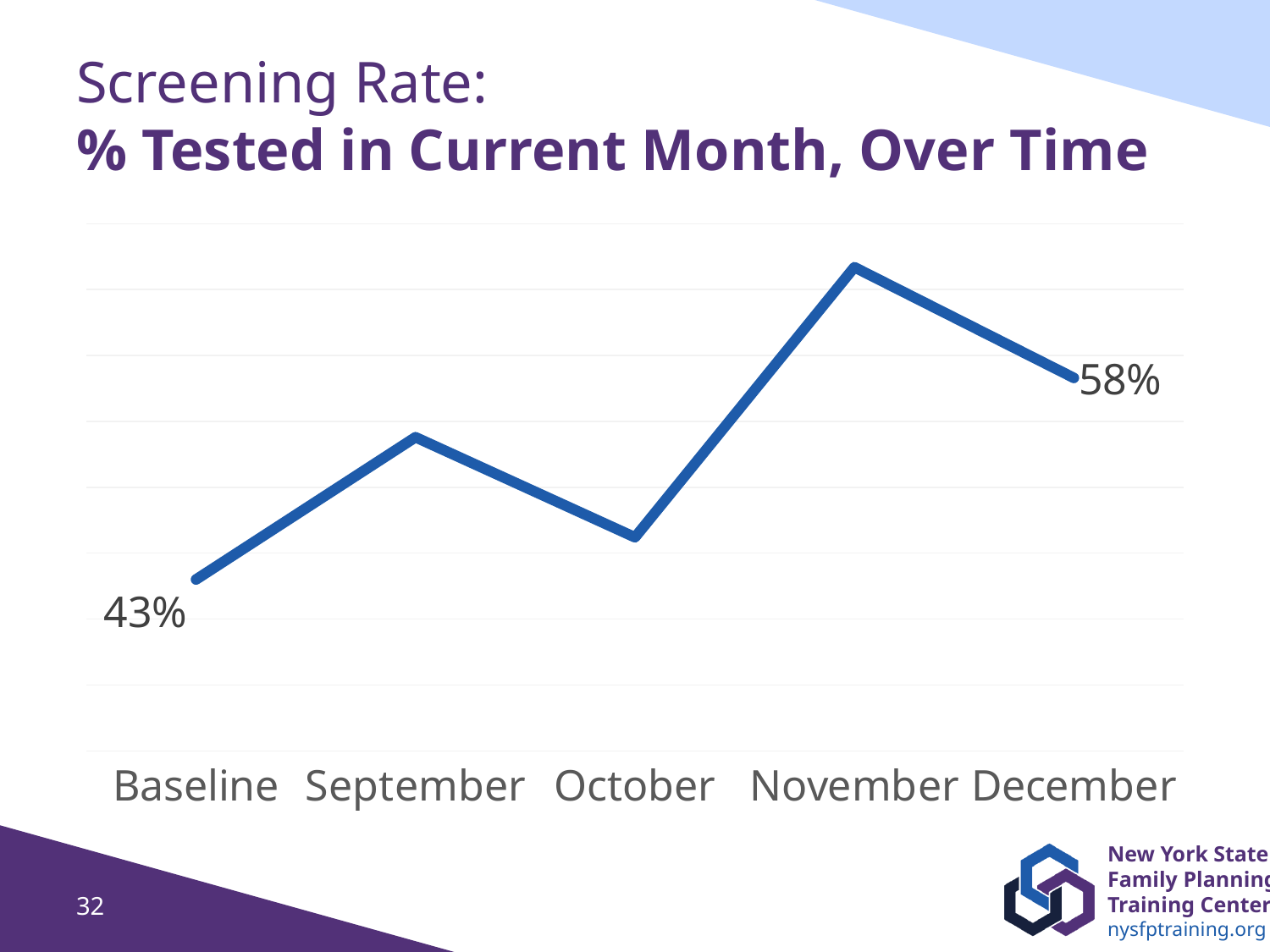
What is the screening rate in December? 58% Overall, does the screening rate rise or fall from Baseline to December? Rise What type of chart is shown on the slide? Line chart Which point on the chart has the highest screening rate? November Which has a higher screening rate, November or December? November How many time points are plotted on the chart? 5 What is the screening rate at Baseline? 43% Which point on the chart has the lowest screening rate? Baseline How many percentage points higher is the December screening rate than the Baseline rate? 15 percentage points Which has a higher screening rate, September or October? September What is the title of the chart on the slide? Screening Rate: % Tested in Current Month, Over Time Which has a higher screening rate, October or December? December